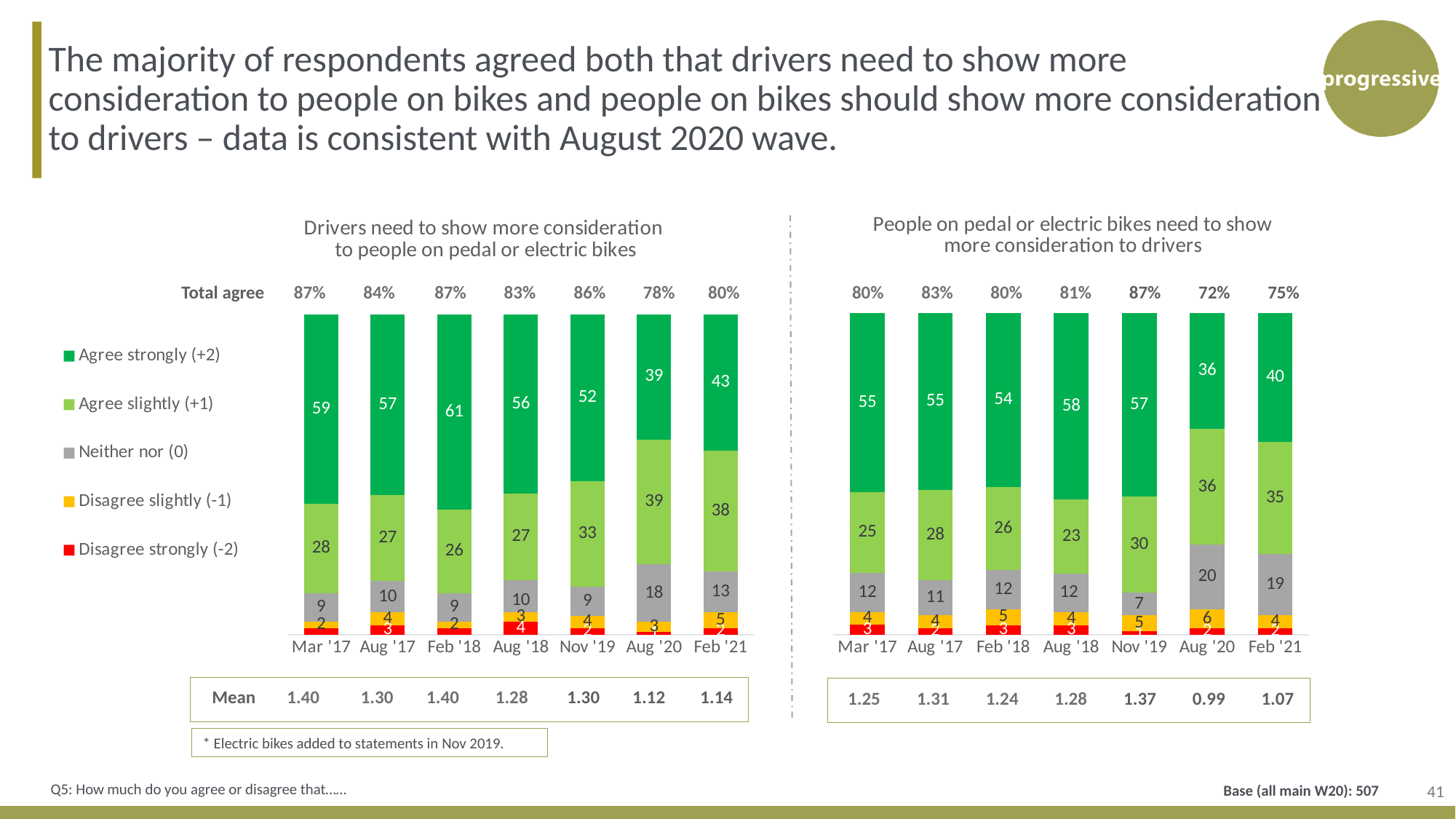
In the left chart, what is the Mean value shown for Aug '20? 1.12 In the right chart, what is the Mean value shown for Aug '20? 0.99 In the left chart, what is the difference between the Agree strongly (+2) values for Feb '18 and Feb '21? 18 In the right chart, which wave has the highest Total agree percentage? Nov '19 How many waves (bars) are shown in the left chart? 7 What type of chart is used on this slide? Stacked bar chart In the right chart (People on pedal or electric bikes need to show more consideration to drivers), what is the Agree slightly (+1) value for Nov '19? 30 In the left chart, what is the Total agree percentage for Aug '20? 78% In the right chart, which wave has the lowest Total agree percentage? Aug '20 In the left chart (Drivers need to show more consideration to people on pedal or electric bikes), what is the Agree strongly (+2) value for Feb '18? 61 How many series does the legend list? 5 In the right chart, which is larger: the Neither nor (0) value for Aug '20 or for Nov '19? Aug '20